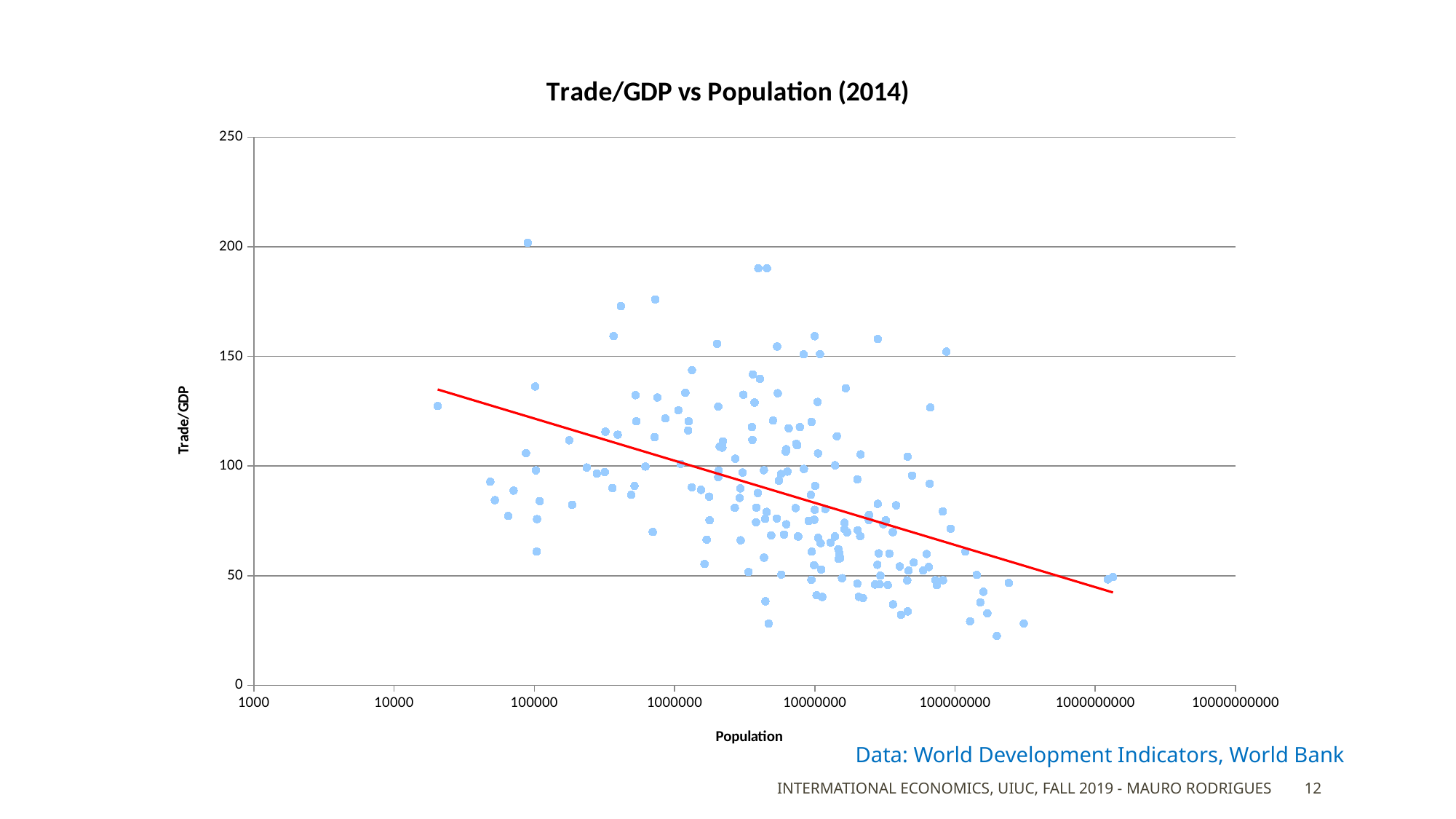
According to the fitted trend line, does Trade/GDP rise or fall as Population increases? Fall Is the lowest plotted Trade/GDP value greater or less than 50? less What is the title of the chart? Trade/GDP vs Population (2014) What kind of chart is shown on the slide? Scatter chart Is the Trade/GDP value of the trend line at a population of 1000000000 greater or less than 100? less Is the Trade/GDP value of the trend line at a population of 100000 greater or less than 100? greater What is the highest value shown on the vertical axis? 250